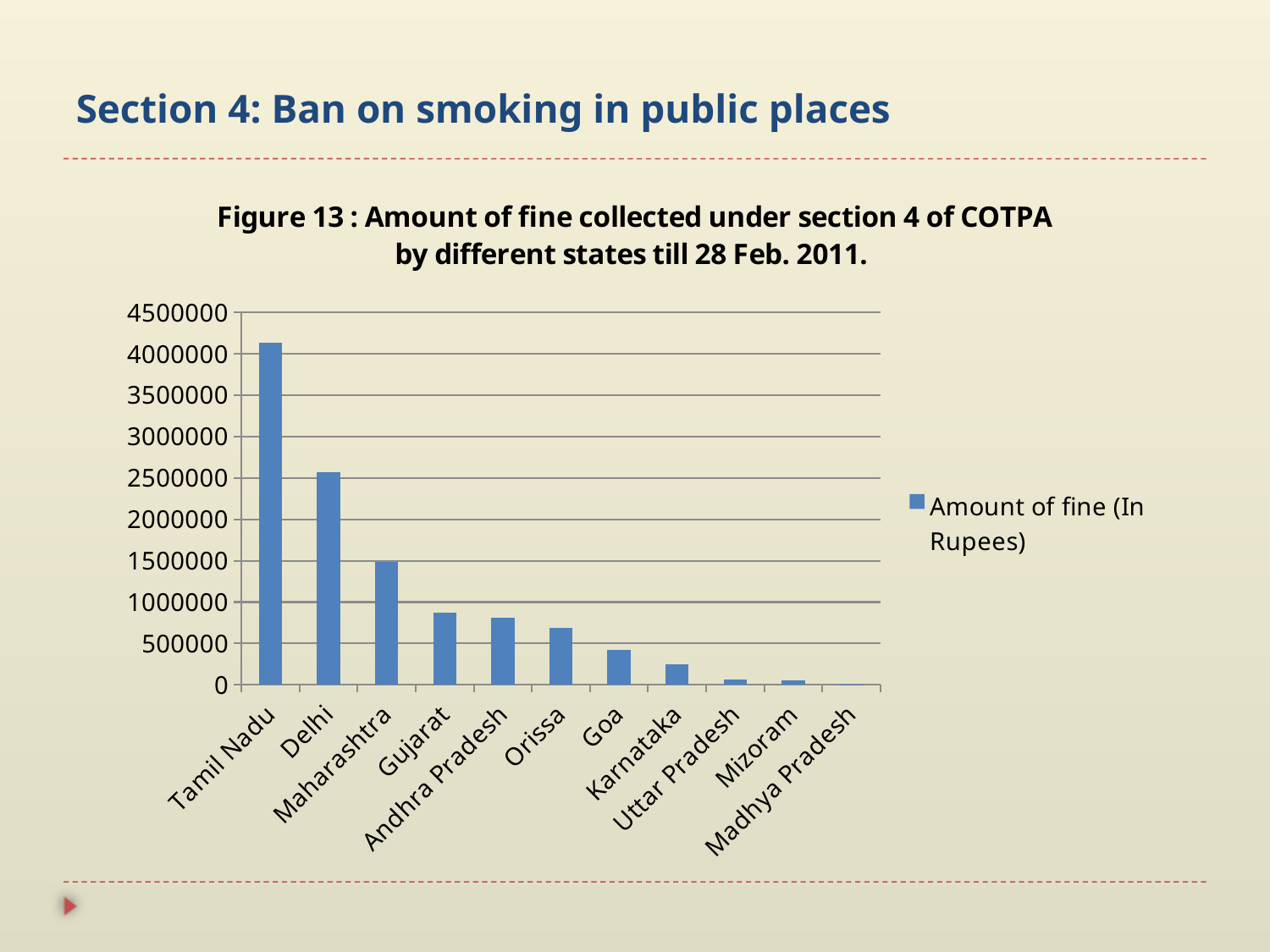
How many series does the legend list? 1 Is the value for Delhi greater or less than 2000000? greater What is the legend entry for the series shown? Amount of fine (In Rupees) Do the values rise or fall moving from left to right along the x axis? fall Which state collected the lowest amount of fine? Madhya Pradesh Which collected more fine, Delhi or Maharashtra? Delhi Is the value for Gujarat greater or less than 1000000? less What type of chart is shown on the slide? bar chart Is the value for Goa greater or less than 500000? less Which state collected the highest amount of fine? Tamil Nadu How many states are shown on the x axis? 11